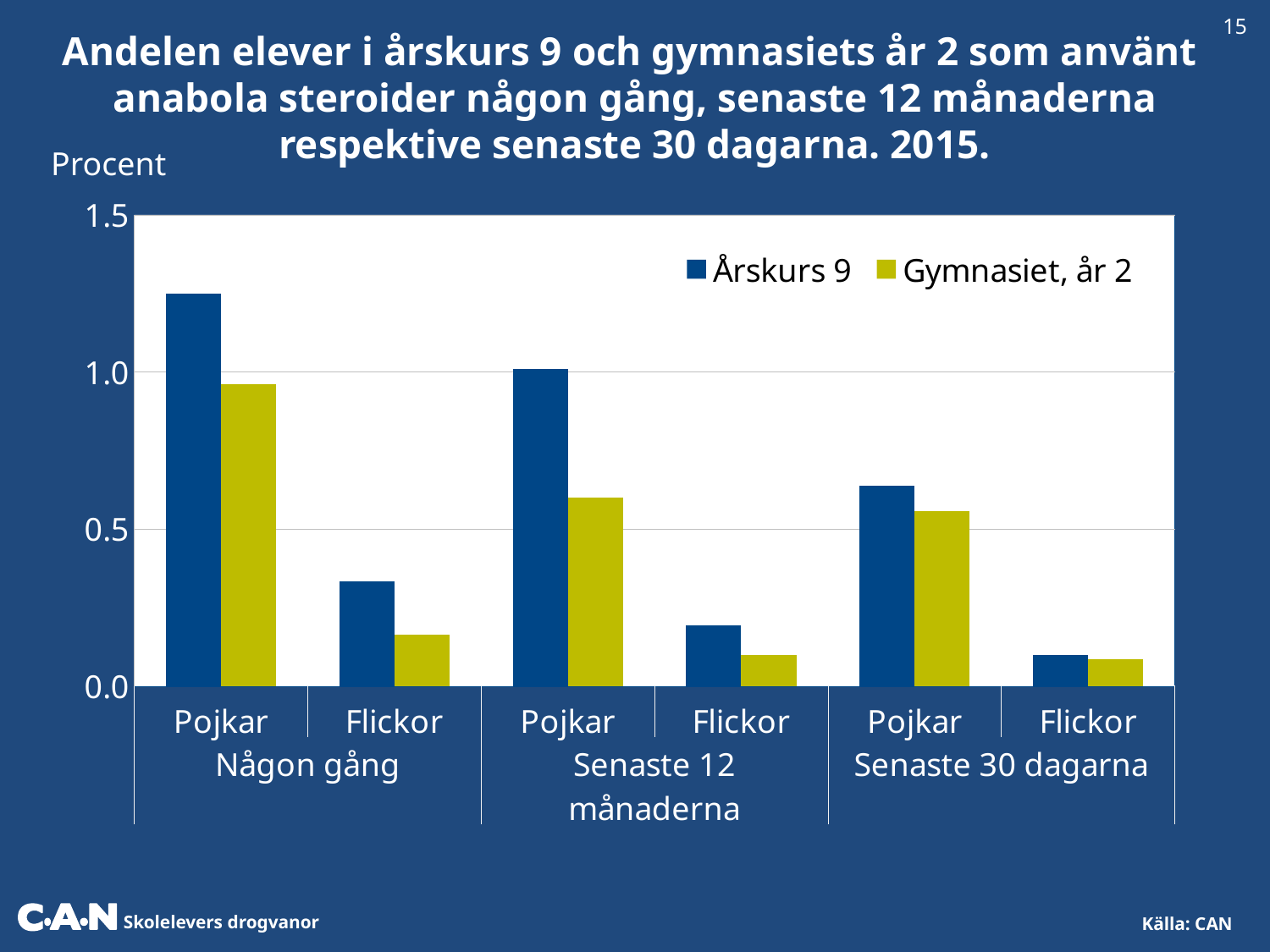
How many series does the legend list? 2 What are the two series named in the legend? Årskurs 9 and Gymnasiet, år 2 What is the label on the vertical axis of the chart? Procent Among the Årskurs 9 bars, which category has the lowest value? Flickor, Senaste 30 dagarna Is the Gymnasiet, år 2 value for Pojkar under Någon gång greater or less than 1.0? less Is the Årskurs 9 value for Flickor under Någon gång greater or less than 0.5? less Is the Gymnasiet, år 2 value for Pojkar under Senaste 12 månaderna greater or less than 0.5? greater How many time-period groups (Någon gång, Senaste 12 månaderna, Senaste 30 dagarna) are shown on the x axis? 3 For Flickor under Någon gång, which series has the larger value, Årskurs 9 or Gymnasiet, år 2? Årskurs 9 What kind of chart is shown on the slide? bar chart Which bar is the highest in the chart? Årskurs 9, Pojkar, Någon gång